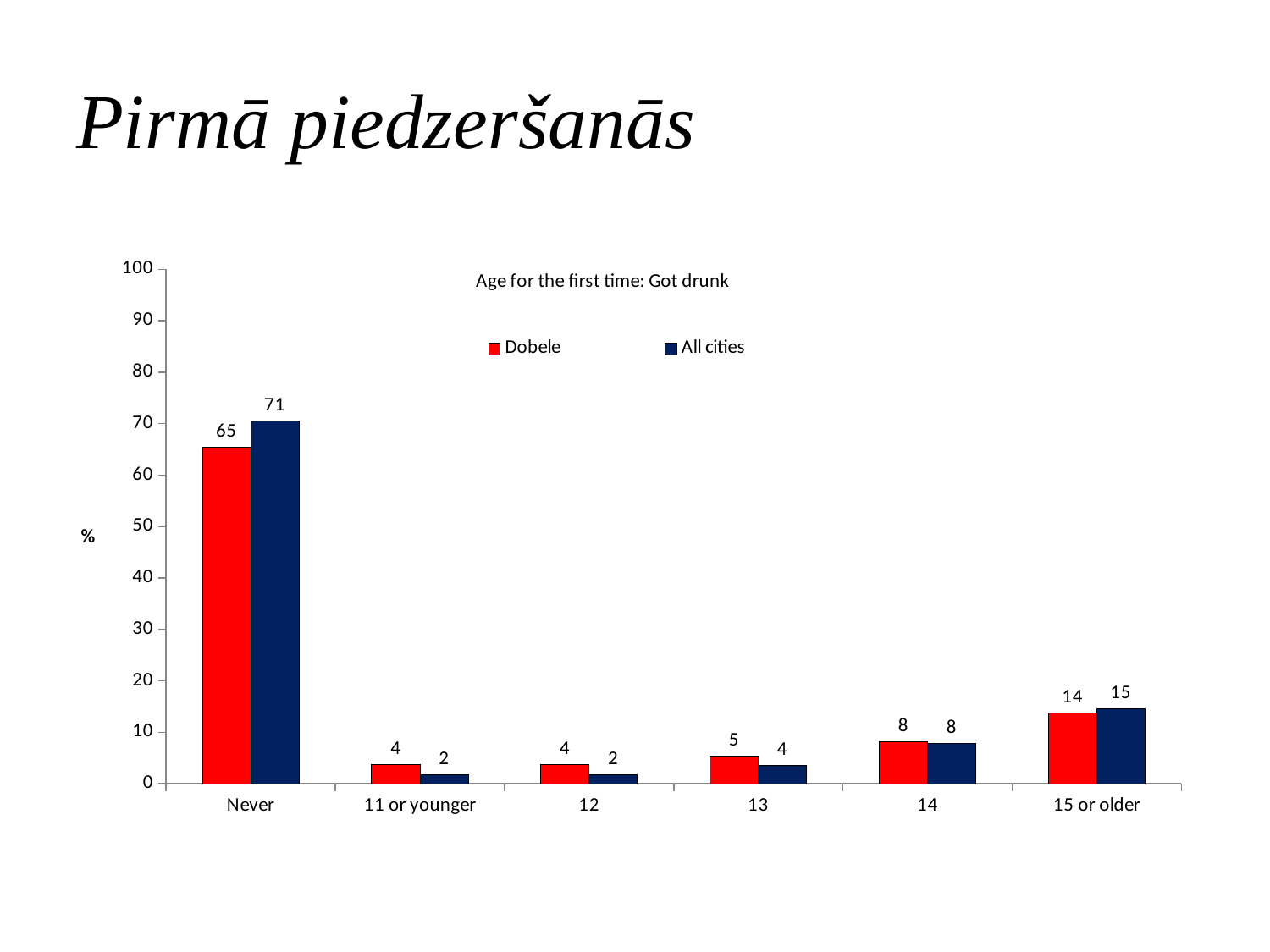
Which is larger in the 12 category, Dobele or All cities? Dobele How many series does the legend list? 2 What is the value for Dobele in the 13 category? 5 Is the value for All cities in the Never category greater or less than 60? greater What kind of chart is shown on the slide? bar chart What is the value for All cities in the Never category? 71 What is the title of the chart? Age for the first time: Got drunk What is the difference between the All cities and Dobele values in the Never category? 6 What is the value for All cities in the 15 or older category? 15 How many categories are shown on the x axis? 6 Which category has the highest value for Dobele? Never What is the value for Dobele in the Never category? 65